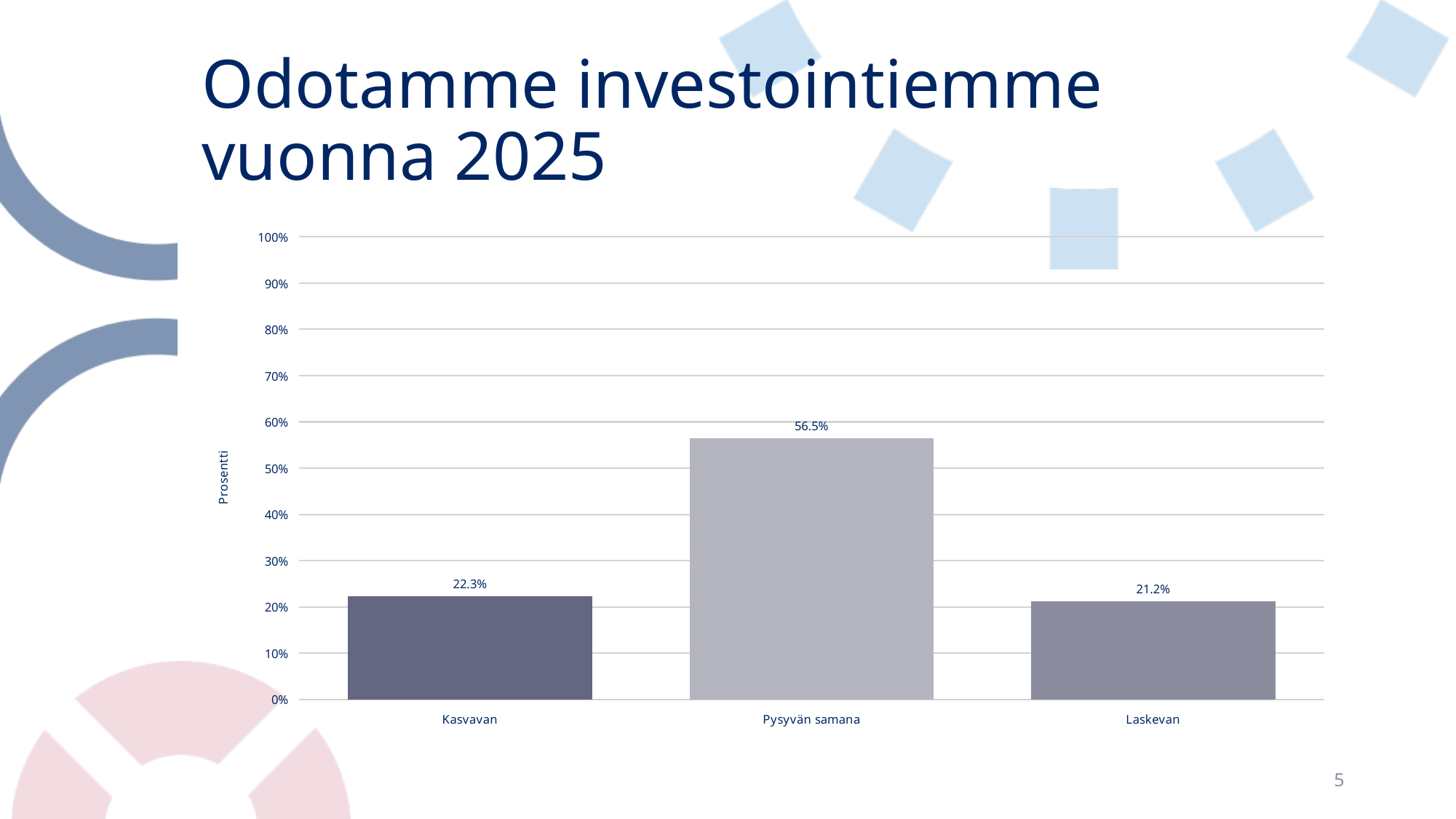
What is the difference between the values for Kasvavan and Laskevan? 1.1% What is the value for Kasvavan? 22.3% How many categories are shown on the x axis? 3 What is the difference between the values for Pysyvän samana and Kasvavan? 34.2% What is the value for Laskevan? 21.2% Which category has the lowest value? Laskevan Which is larger, the value for Kasvavan or the value for Laskevan? Kasvavan What is the value for Pysyvän samana? 56.5% What kind of chart is shown on the slide? bar chart Which category has the highest value? Pysyvän samana Is the value for Pysyvän samana greater or less than 50%? greater What is the label of the vertical axis? Prosentti